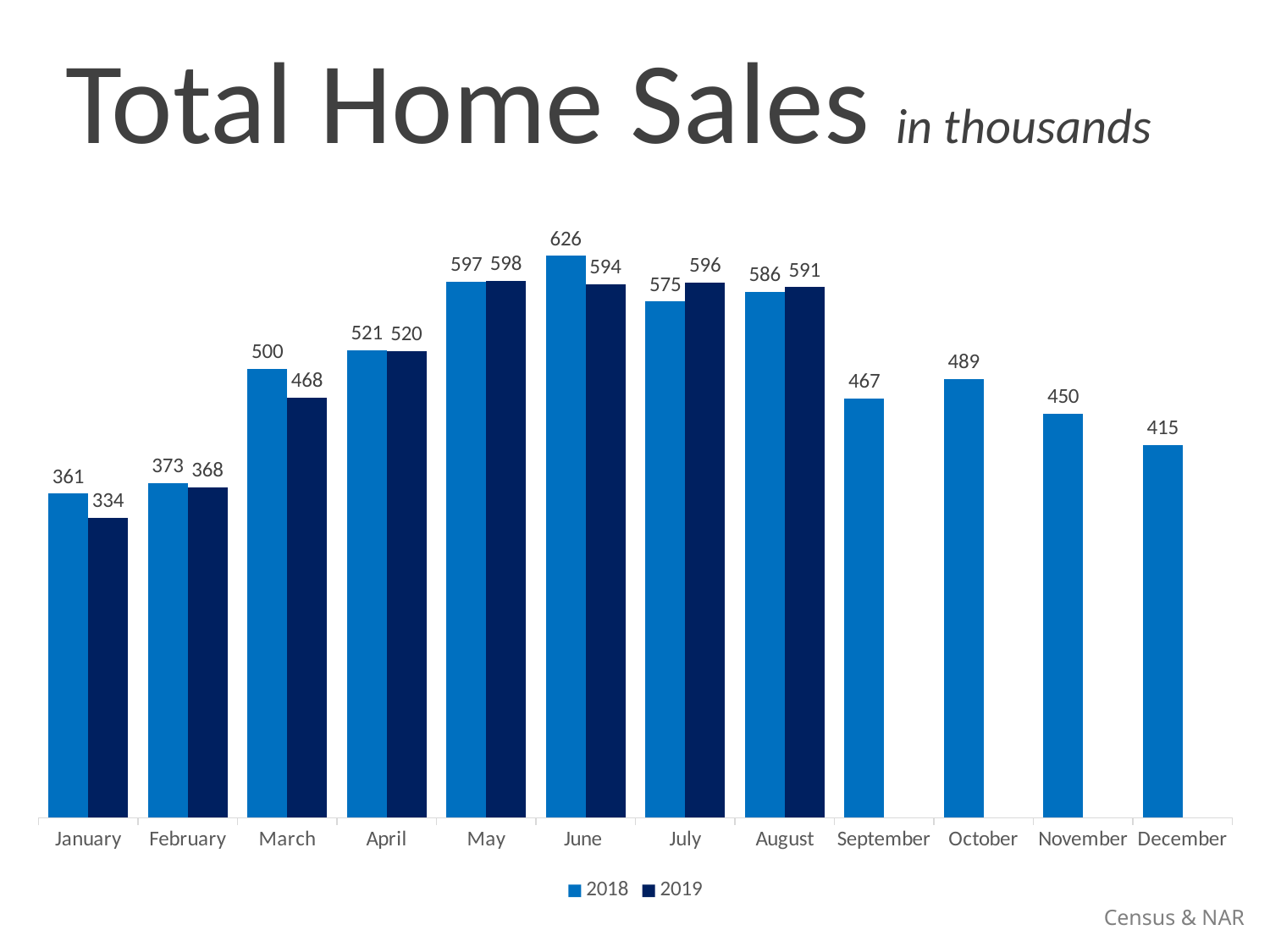
Which month has the lowest 2019 value? January Which month has the highest 2018 value? June What was the value for 2019 in March? 468 What was the value for 2018 in December? 415 Which is larger, the 2018 value for January or the 2019 value for January? 2018 How many series does the legend list? 2 What kind of chart is shown on the slide? Bar chart What was the value for 2018 in June? 626 What is the title of the chart? Total Home Sales What is the difference between the 2018 and 2019 values for March? 32 How many months are shown on the x axis? 12